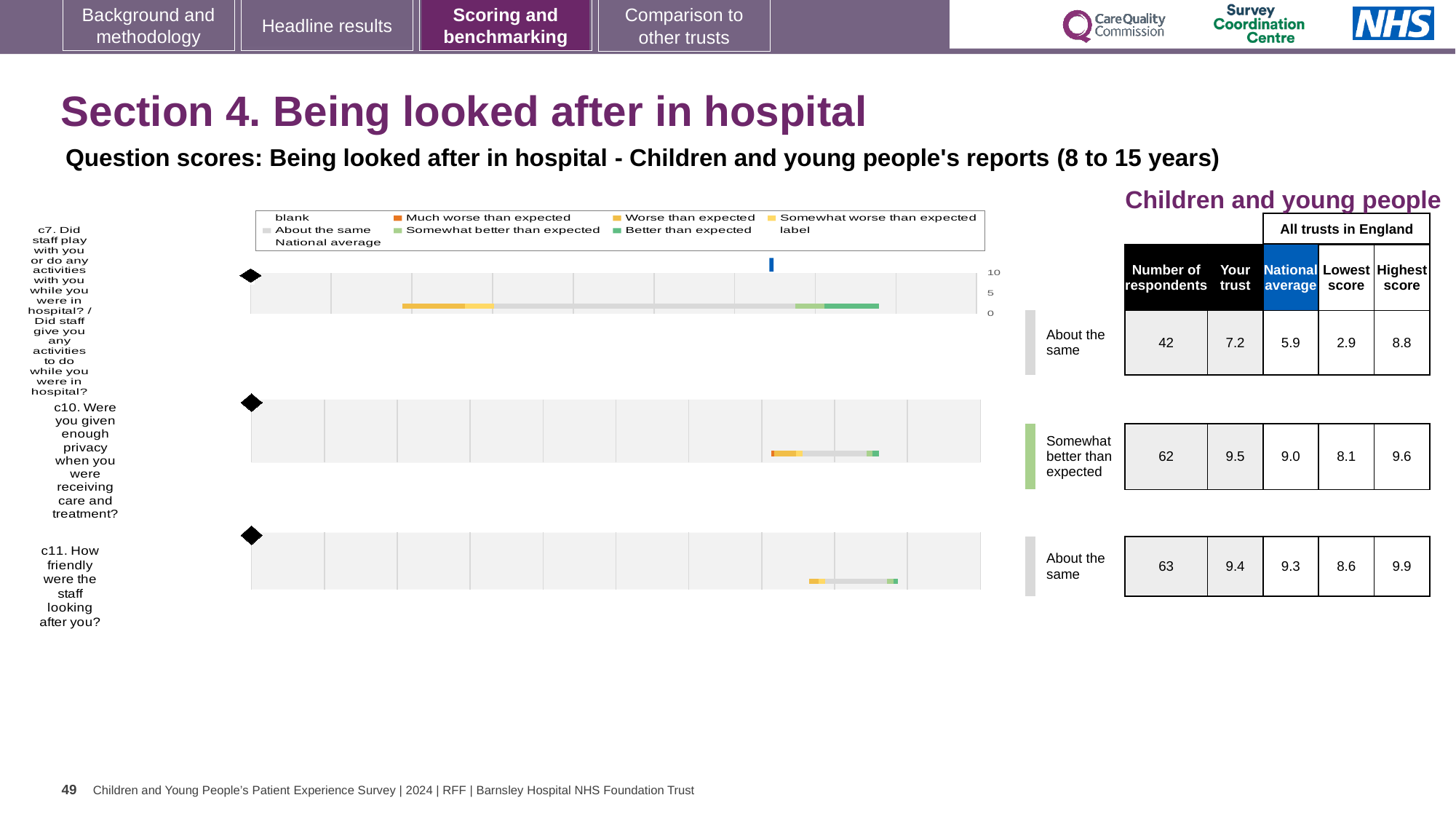
What is the difference between the trust's score and the national average for question c7? 1.3 What kind of chart is used to show the question scores on this slide? Bar chart How many survey questions (c7, c10, c11) have a chart on this slide? 3 Which question has the highest 'Your trust' score? c10 What is the maximum value shown on the score axis of the charts? 10 What is the national average score for question c7 (staff playing or doing activities with you)? 5.9 What is the lowest score across all trusts in England for question c10? 8.1 Which question has the lowest 'Your trust' score? c7 How many respondents answered question c11 (how friendly were the staff)? 63 What benchmark category is shown for question c10? Somewhat better than expected For question c11, which is larger: the trust's score or the national average? Your trust What is the 'Your trust' score for question c10 (privacy when receiving care and treatment)? 9.5